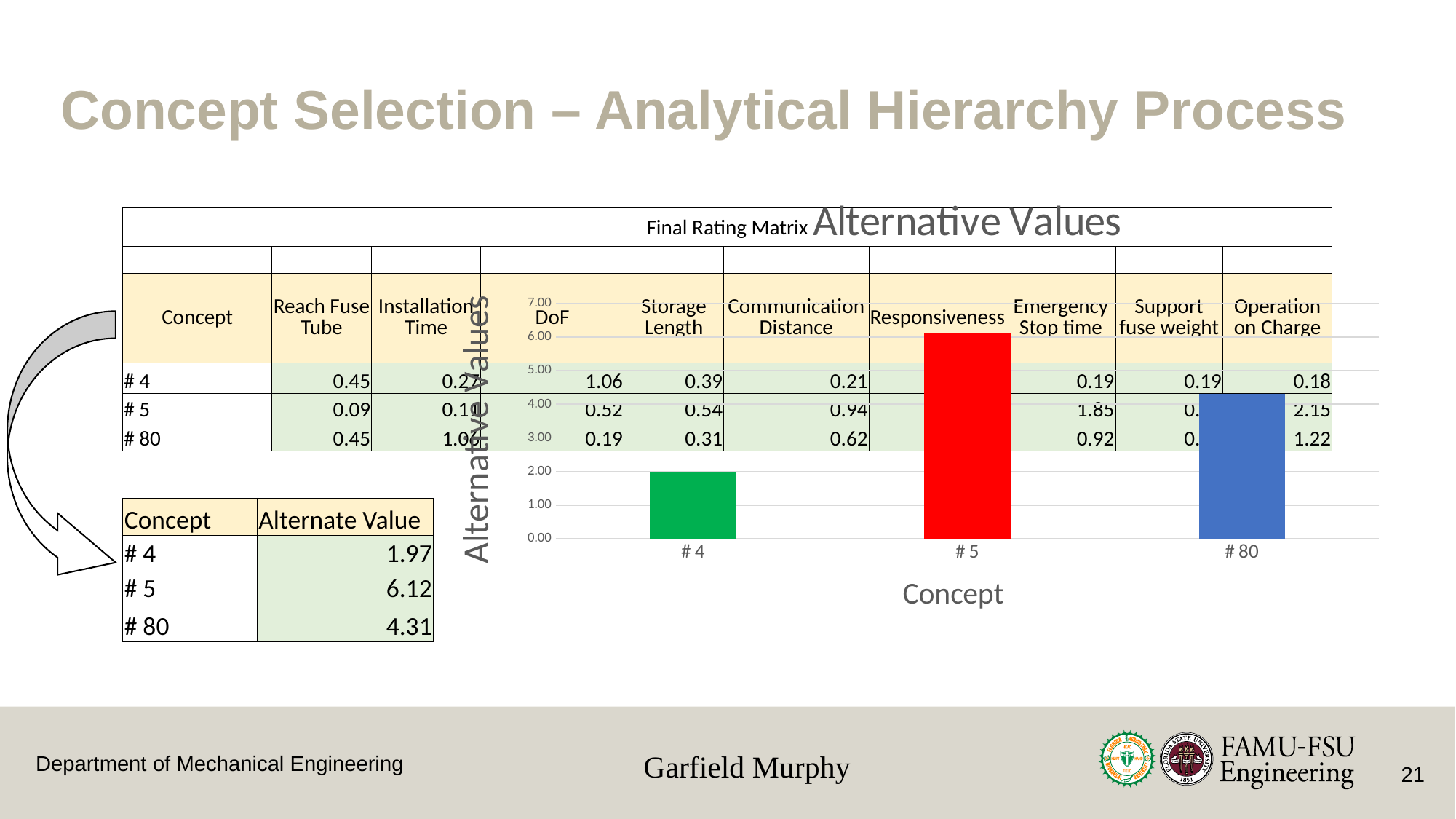
Which concept has the highest bar in the chart? # 5 How many concepts are plotted in the chart? 3 What is the label of the x axis of the chart? Concept Which has the larger value, # 80 or # 4? # 80 What is the title of the chart? Alternative Values Is the value for # 80 greater or less than 4.00? greater What kind of chart is shown on the slide? bar chart Does the value rise or fall from # 5 to # 80? fall Is the value for # 4 greater or less than 3.00? less Is the value for # 5 greater or less than 5.00? greater Which concept has the lowest bar in the chart? # 4